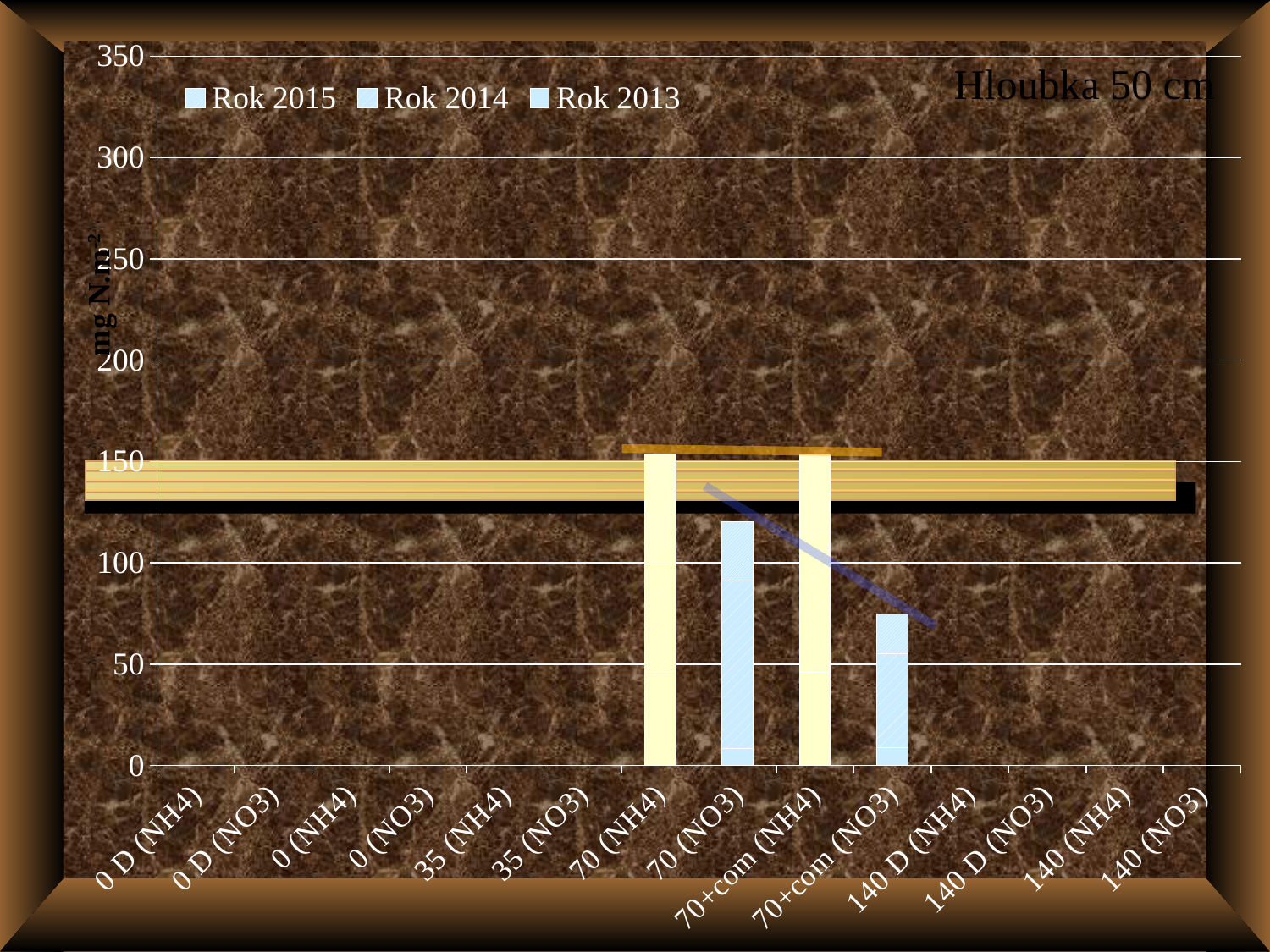
How many series does the legend list? 3 Is the value for 70+com (NO3) greater or less than 50? greater Is the value for 70+com (NO3) greater or less than 100? less Which is larger, the value for 70 (NH4) or the value for 70 (NO3)? 70 (NH4) What is the label of the vertical axis? mg N.m² Is the value for 70 (NO3) greater or less than 100? greater What kind of chart is shown on the slide? bar chart What is the title of the chart? Hloubka 50 cm Which is larger, the value for 70 (NO3) or the value for 70+com (NO3)? 70 (NO3) How many categories are shown on the x axis? 14